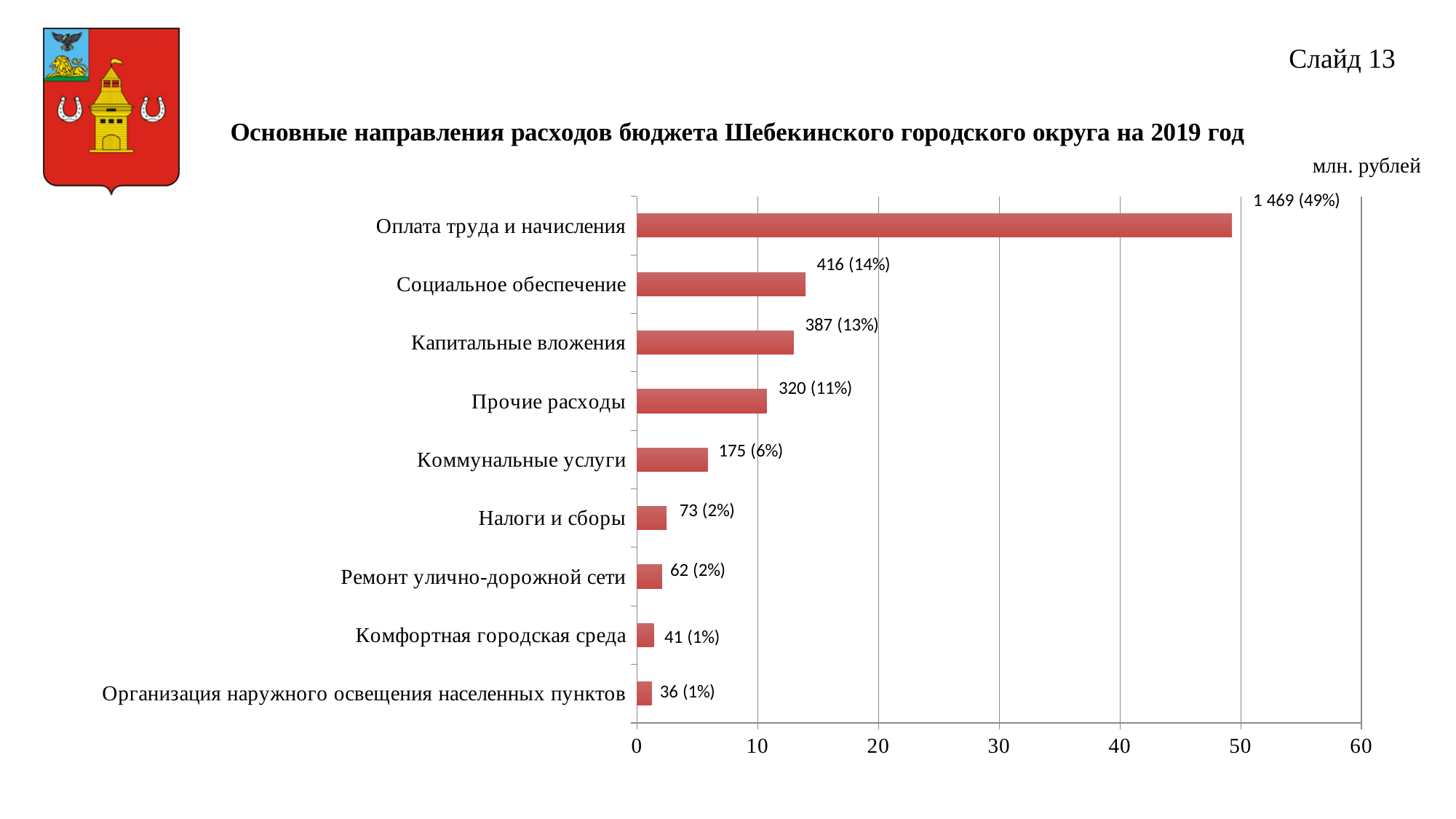
What is the difference in million rubles between Социальное обеспечение (416) and Капитальные вложения (387)? 29 What is the data label for Коммунальные услуги? 175 (6%) Which is larger, Прочие расходы or Коммунальные услуги? Прочие расходы Is the bar for Оплата труда и начисления greater or less than 50 on the axis? less What is the data label for Социальное обеспечение? 416 (14%) What kind of chart is shown on the slide? bar chart What is the data label for Оплата труда и начисления? 1 469 (49%) Which category has the lowest value? Организация наружного освещения населенных пунктов What is the data label for Организация наружного освещения населенных пунктов? 36 (1%) What unit is indicated above the chart? млн. рублей Which category has the highest value? Оплата труда и начисления How many categories are shown in the chart? 9